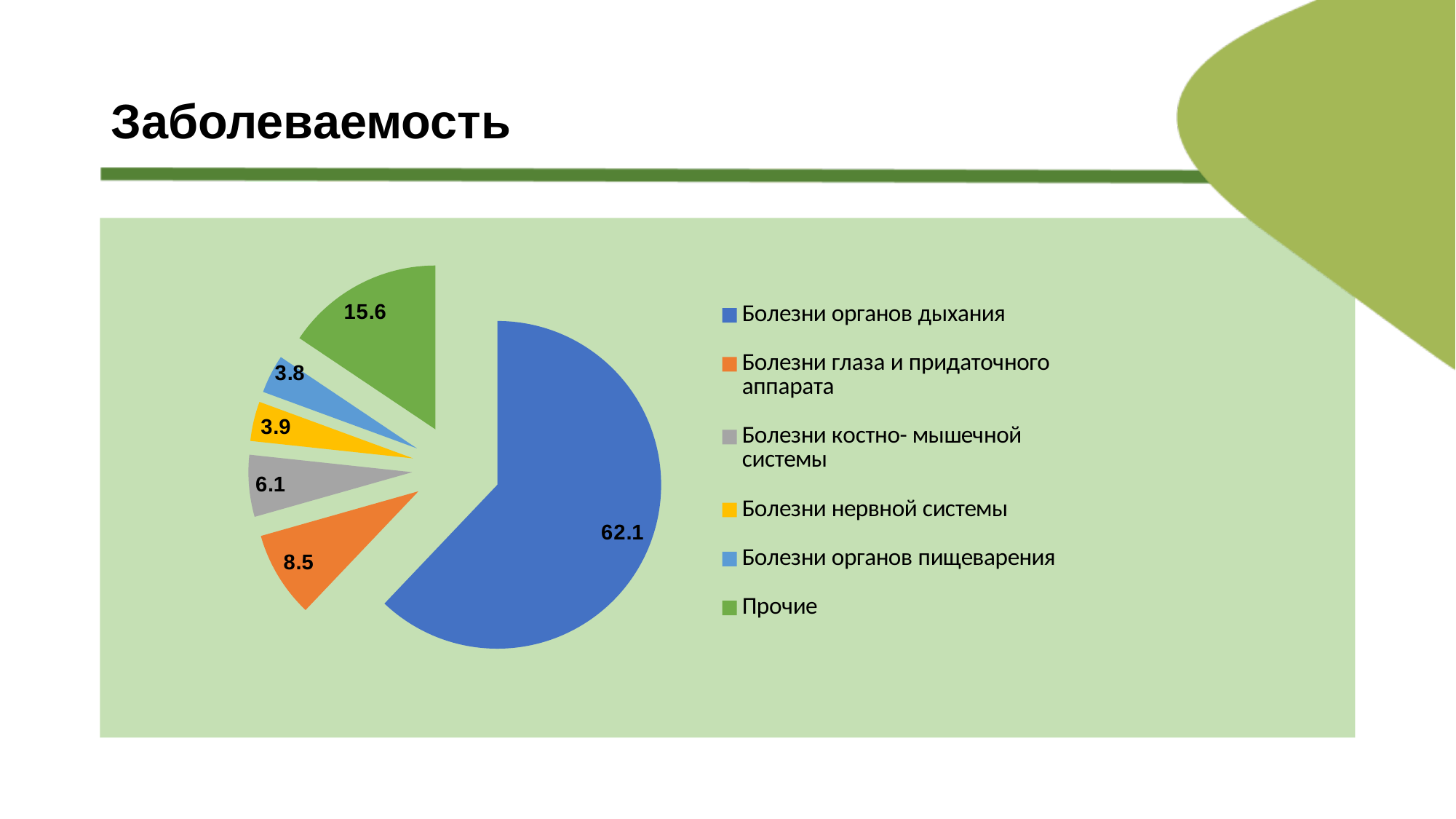
What is the value for Болезни органов пищеварения? 3.8 What is the value for Прочие? 15.6 What is the difference between the values for Прочие and Болезни глаза и придаточного аппарата? 7.1 What is the value for Болезни глаза и придаточного аппарата? 8.5 Which is larger, the value for Болезни костно-мышечной системы or the value for Болезни нервной системы? Болезни костно-мышечной системы Which category has the smallest slice of the pie? Болезни органов пищеварения Which category has the largest slice of the pie? Болезни органов дыхания What is the value for Болезни костно-мышечной системы? 6.1 What colour is the slice for Болезни нервной системы? yellow How many slices does the pie chart have? 6 What kind of chart is shown on the slide? pie chart What is the value for Болезни органов дыхания? 62.1